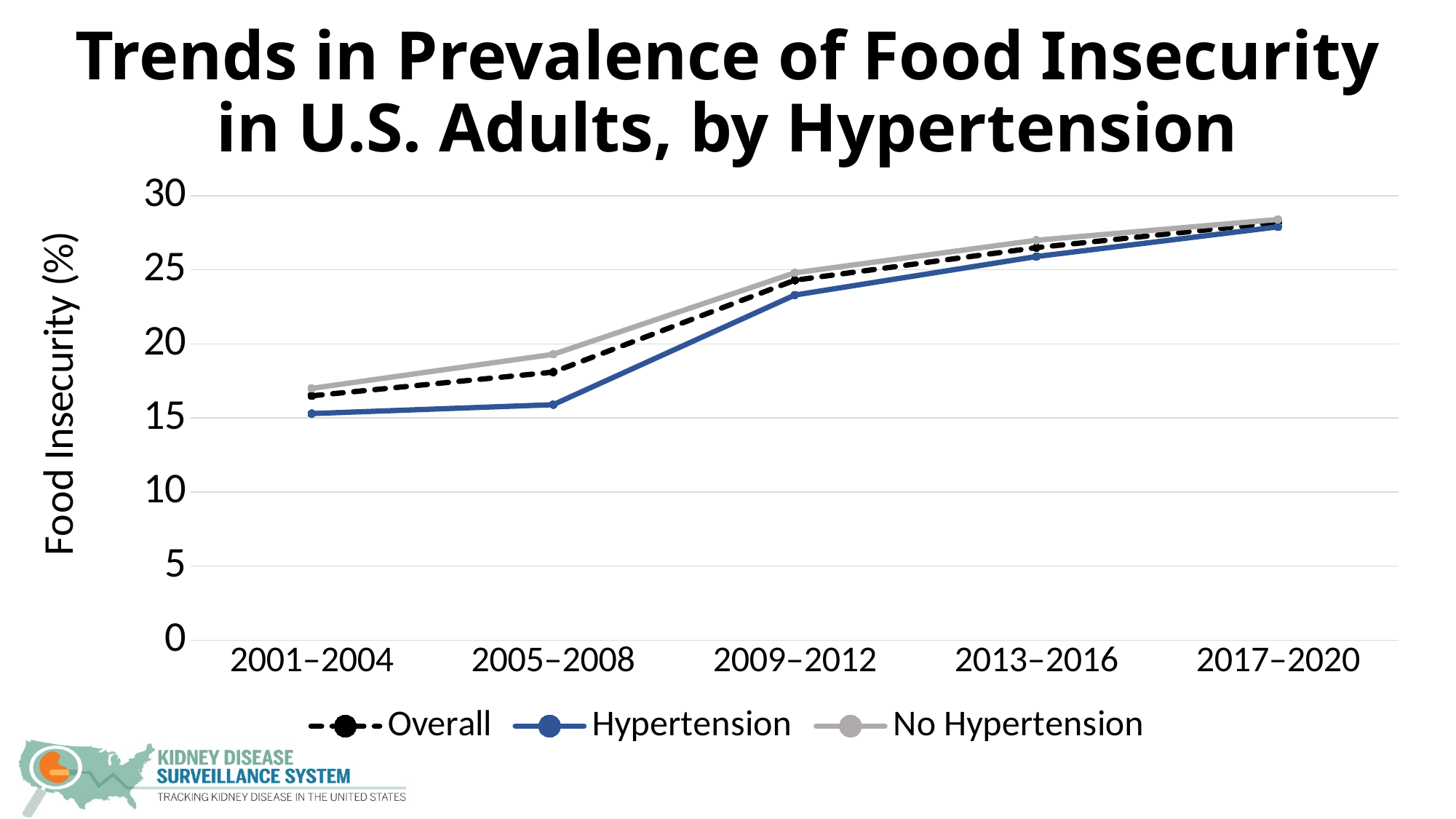
In which period is the Hypertension value lowest? 2001–2004 In 2005–2008, which is larger: the value for Hypertension or for No Hypertension? No Hypertension How many time periods are shown on the x axis? 5 How many series does the legend list? 3 Which series is drawn with a dashed black line? Overall Is the value for Hypertension in 2001–2004 greater or less than 20? less What is the label of the y axis? Food Insecurity (%) Is the value for Hypertension in 2009–2012 greater or less than 20? greater Is the value for No Hypertension in 2009–2012 greater or less than 20? greater Does the Hypertension line rise or fall from 2001–2004 to 2017–2020? Rises What type of chart is shown on the slide? Line chart